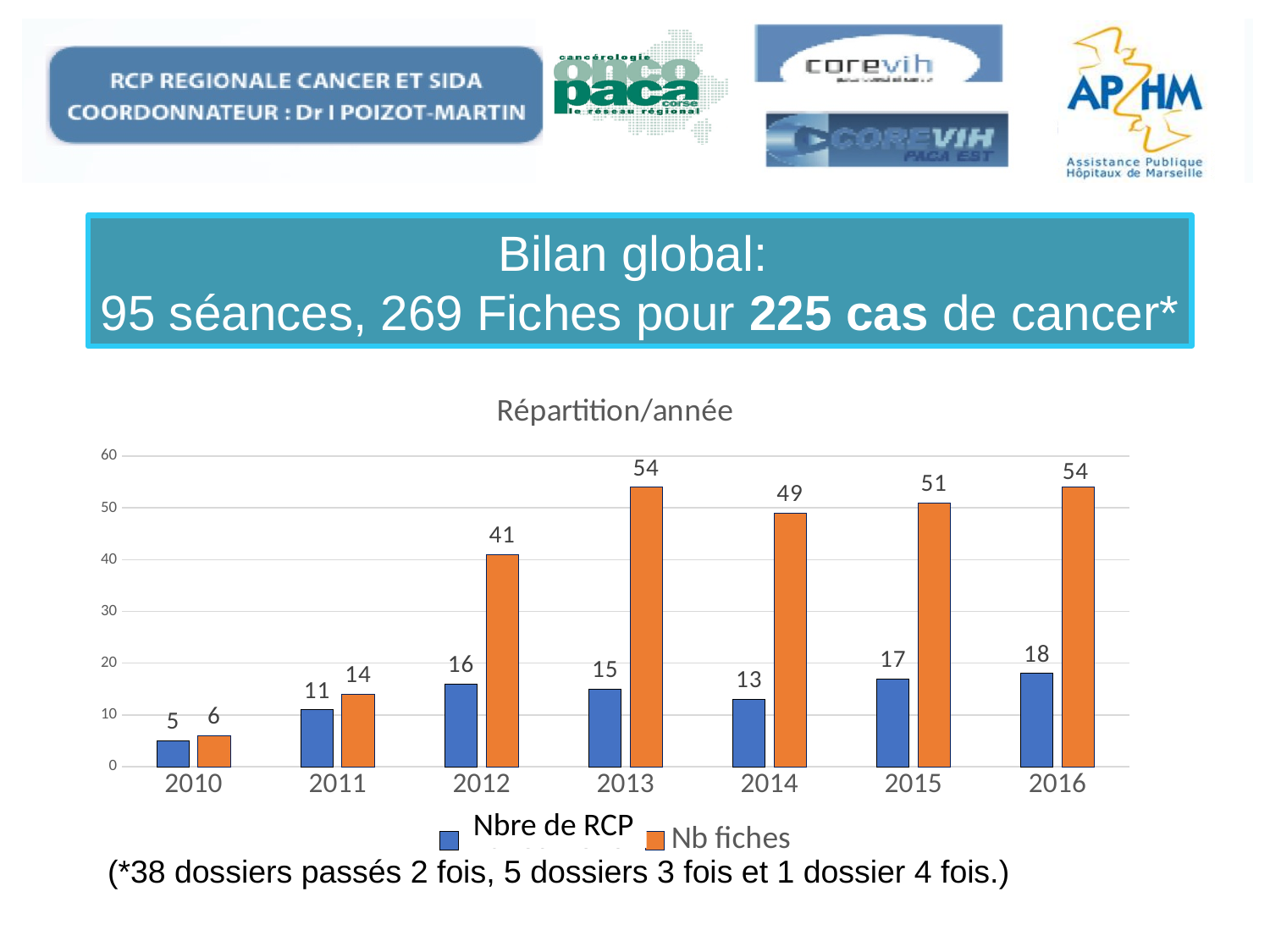
Which year has the lowest value for Nbre de RCP? 2010 What is the title of the chart? Répartition/année What is the value of Nb fiches for 2012? 41 Does the Nb fiches series rise or fall from 2010 to 2013? Rise How many series does the legend list? 2 What is the difference between Nb fiches and Nbre de RCP in 2013? 39 Which year has the highest value for Nbre de RCP? 2016 What kind of chart is shown? Bar chart What is the difference in Nb fiches between 2016 and 2010? 48 Which is larger in 2011: Nbre de RCP or Nb fiches? Nb fiches How many years are shown on the x axis? 7 What is the value of Nbre de RCP for 2014? 13